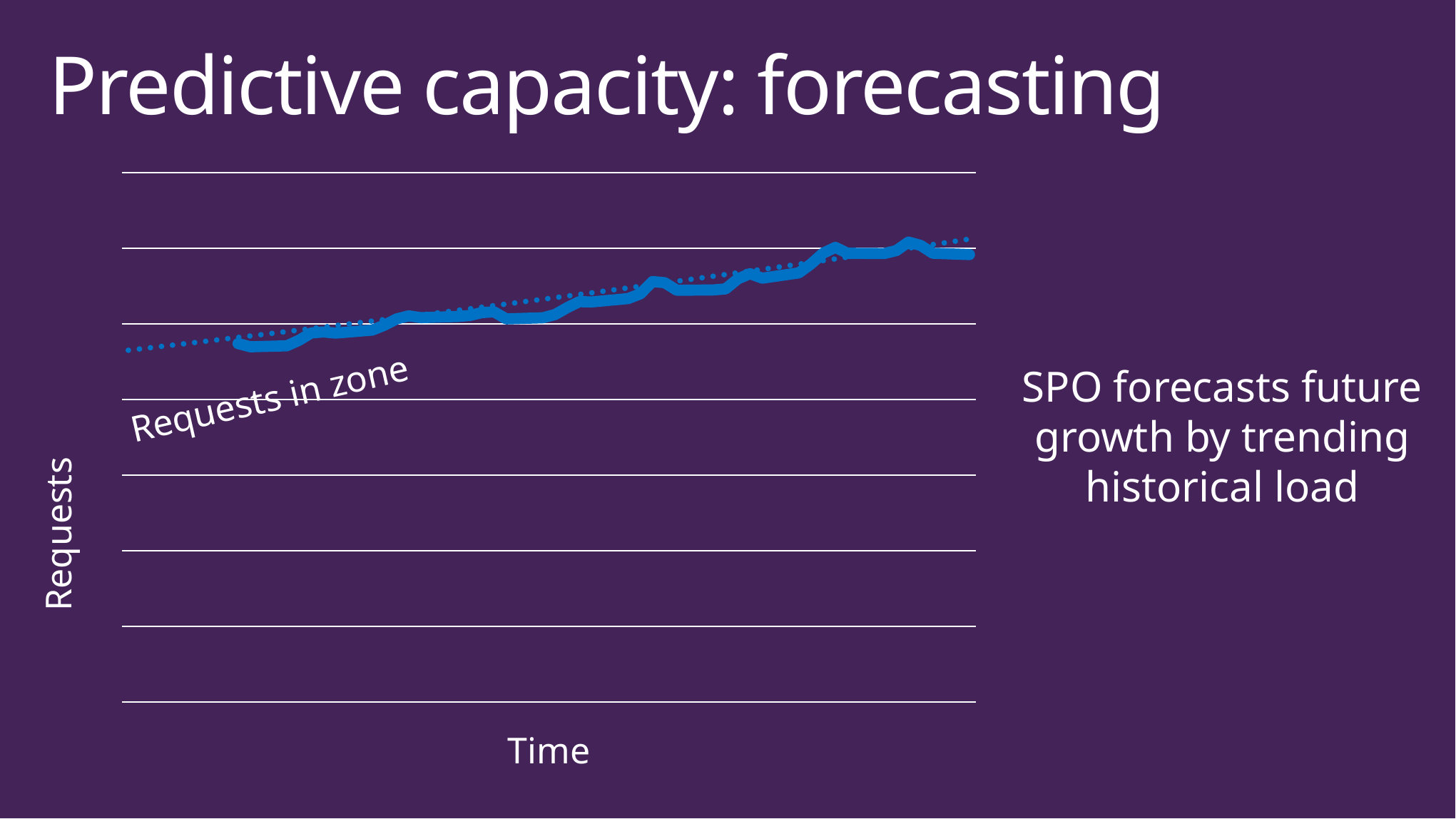
Is the "Requests in zone" line higher at the right end of the chart or at the left end? right end What kind of chart is shown on the slide? line chart Do the values of the "Requests in zone" line rise or fall along the x axis? rise What is the title of the vertical axis of the chart? Requests What is the title of the horizontal axis of the chart? Time What is the label of the plotted data series on the chart? Requests in zone